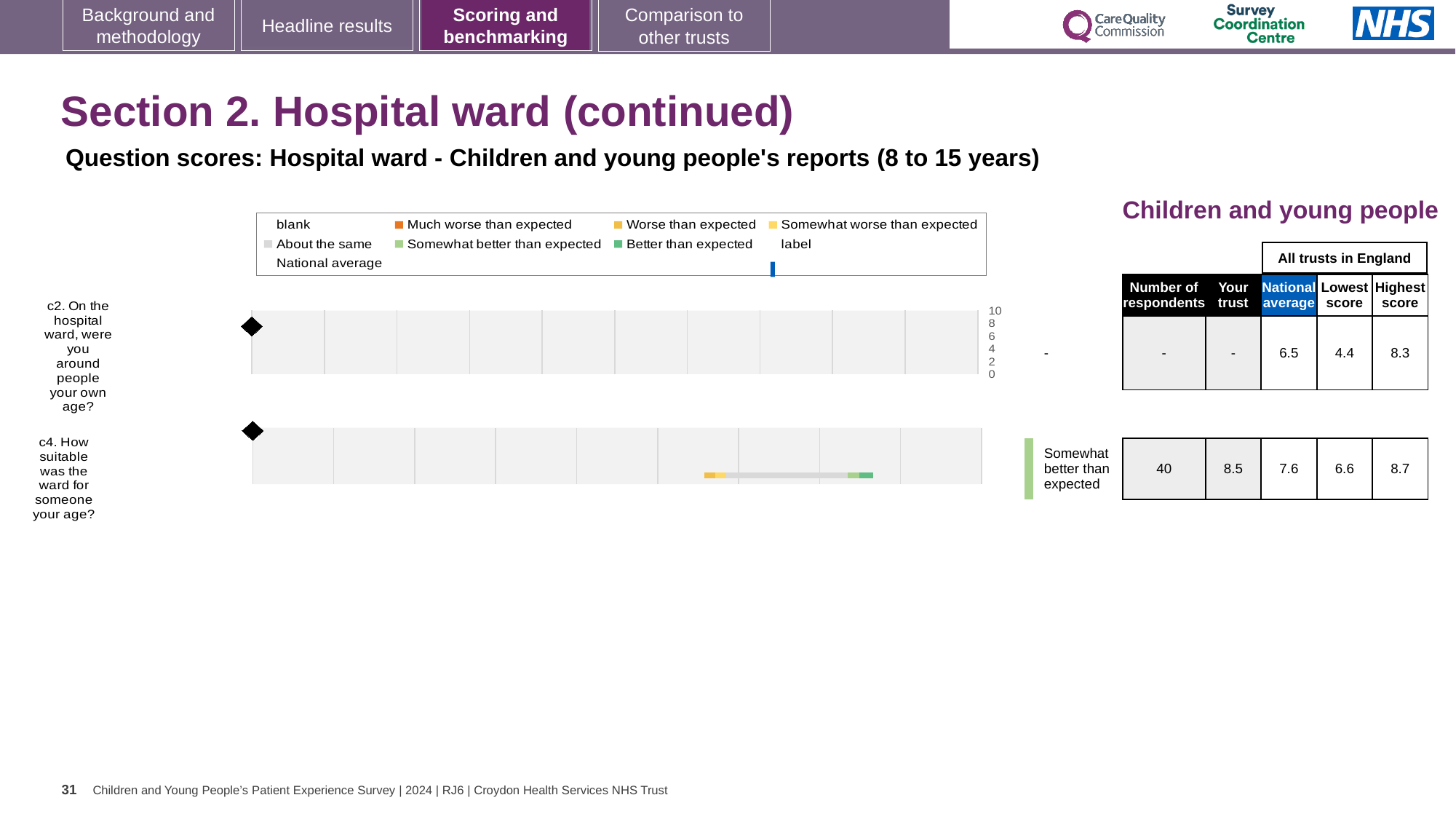
Does the chart for question c2 show any plotted benchmark data? No For question c4, what is the difference between the highest score (8.7) and the lowest score (6.6) across all trusts in England? 2.1 For question c4, is the trust's score higher or lower than the national average? higher In the table beside the c4 chart, what is the 'Your trust' score for question c4? 8.5 Which colour in the legend represents 'Better than expected'? green What kind of chart is used to show the benchmark for question c4? bar chart In the table beside the c4 chart, how many respondents answered question c4? 40 In the table beside the c4 chart, what is the national average for question c4? 7.6 For question c2, what is the national average shown in the table beside the chart? 6.5 How many questions (c2 and c4) have a benchmark chart on the slide? 2 What benchmark rating is shown for question c4, 'How suitable was the ward for someone your age?' Somewhat better than expected